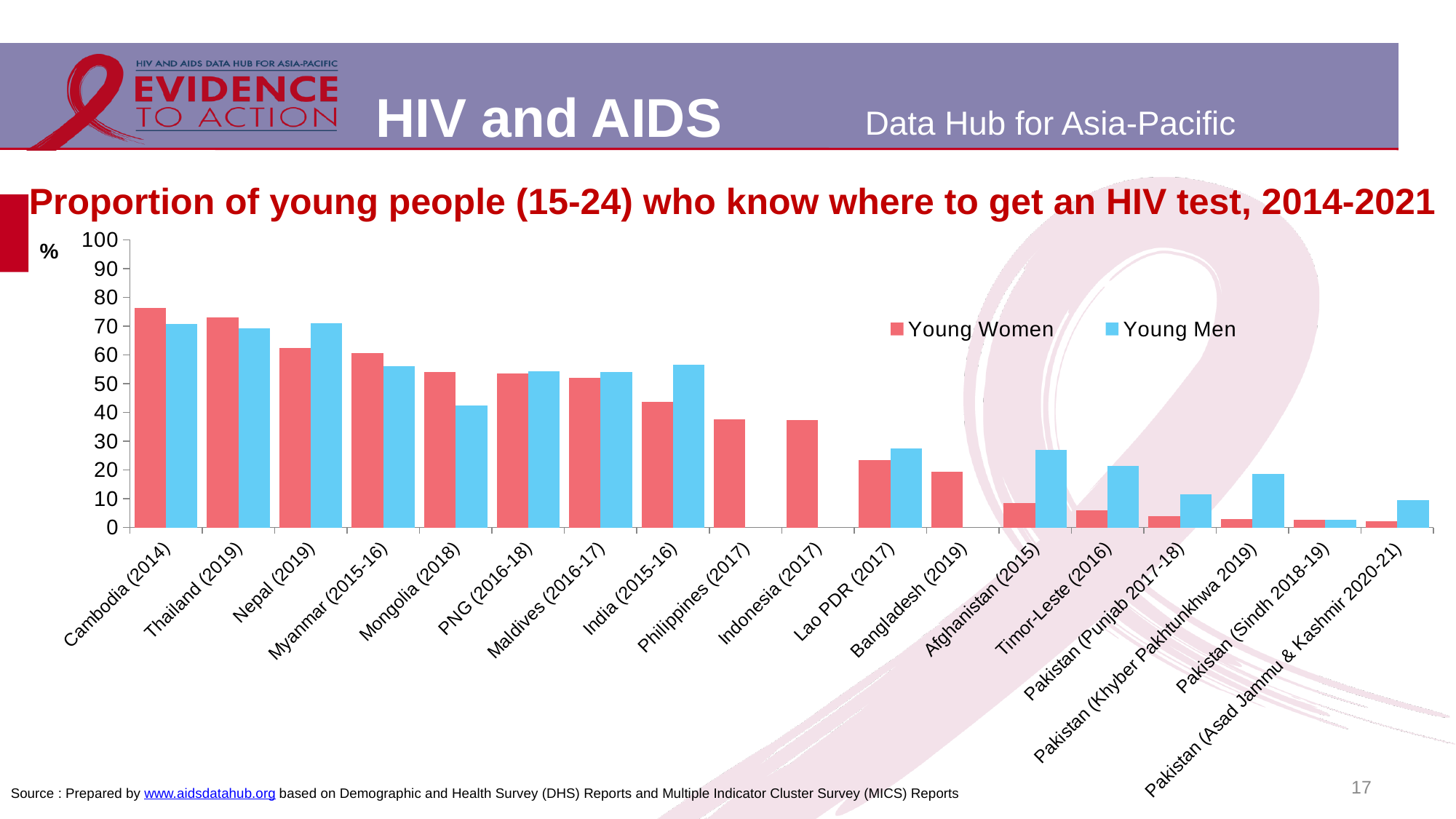
How many series does the legend list? 2 For Nepal (2019), which is larger: the Young Women value or the Young Men value? Young Men Do the Young Women values rise or fall moving from left to right along the x axis? fall For Mongolia (2018), which is larger: the Young Women value or the Young Men value? Young Women Which category has the lowest value for Young Men? Pakistan (Sindh 2018-19) Is the Young Women value for Cambodia (2014) greater or less than 70? greater Which country has the highest value for Young Women? Cambodia (2014) How many countries or regions are shown on the x axis? 18 Is the Young Women value for Afghanistan (2015) greater or less than 10? less What kind of chart is shown on the slide? Bar chart Is the Young Men value for Mongolia (2018) greater or less than 50? less Which colour represents Young Men in the legend? Blue